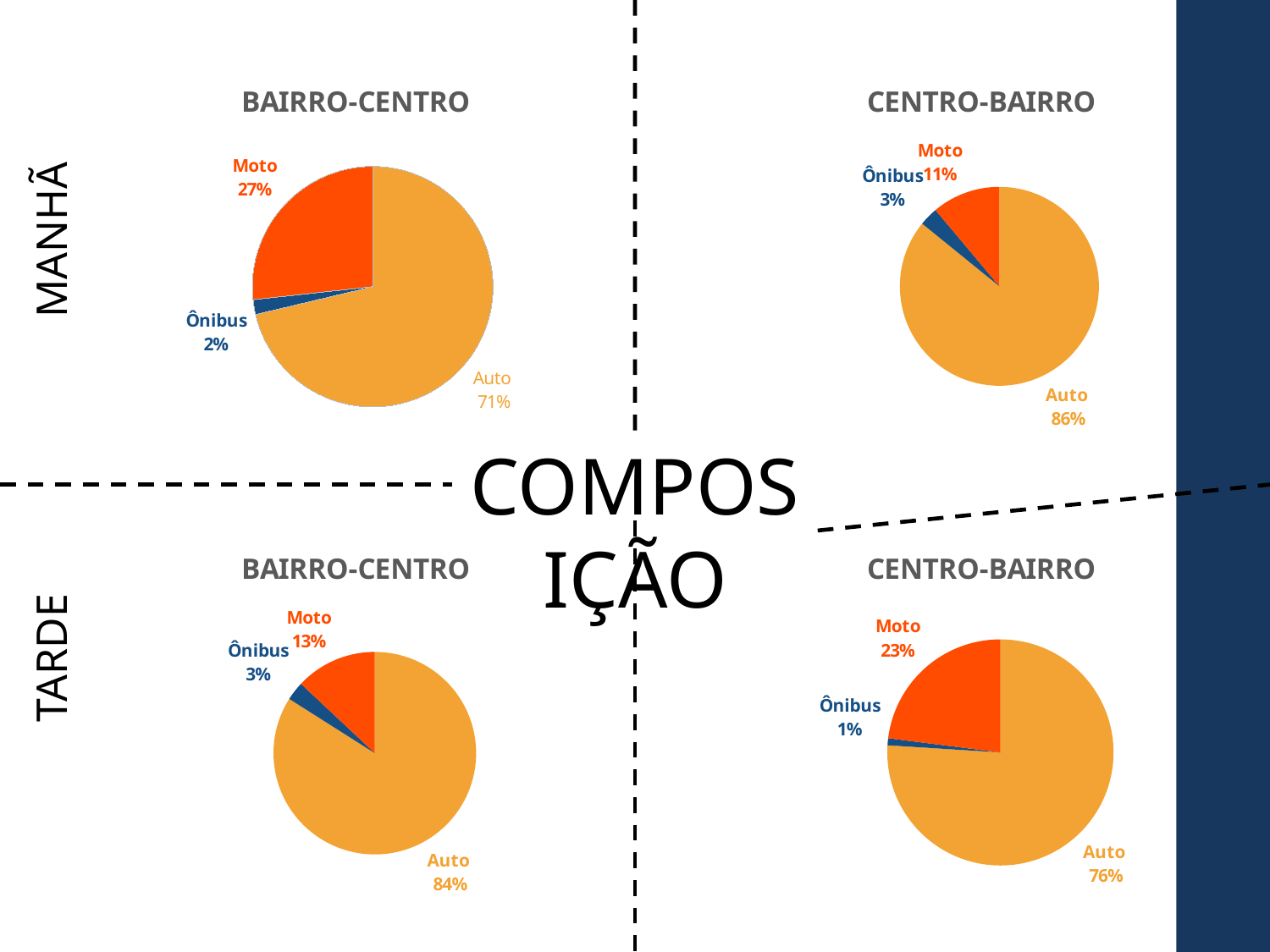
How many pie charts are shown on the slide? 4 How many slices does the MANHÃ BAIRRO-CENTRO pie chart (top left) have? 3 In the MANHÃ CENTRO-BAIRRO pie chart (top right), what share does Auto have? 86% In the MANHÃ CENTRO-BAIRRO pie chart (top right), what is the difference between the Auto share and the Moto share? 75% In the TARDE CENTRO-BAIRRO pie chart (bottom right), what share does Moto have? 23% What type of chart is used in the TARDE CENTRO-BAIRRO chart (bottom right)? pie chart In the TARDE BAIRRO-CENTRO pie chart (bottom left), is the Moto slice larger or smaller than the Ônibus slice? larger In the TARDE CENTRO-BAIRRO pie chart (bottom right), which category has the largest slice? Auto In the MANHÃ BAIRRO-CENTRO pie chart (top left), which category has the smallest slice? Ônibus In the MANHÃ BAIRRO-CENTRO pie chart (top left), what share does Moto have? 27% In the MANHÃ BAIRRO-CENTRO pie chart (top left), what colour is the Auto slice? orange In the TARDE BAIRRO-CENTRO pie chart (bottom left), what share does Ônibus have? 3%